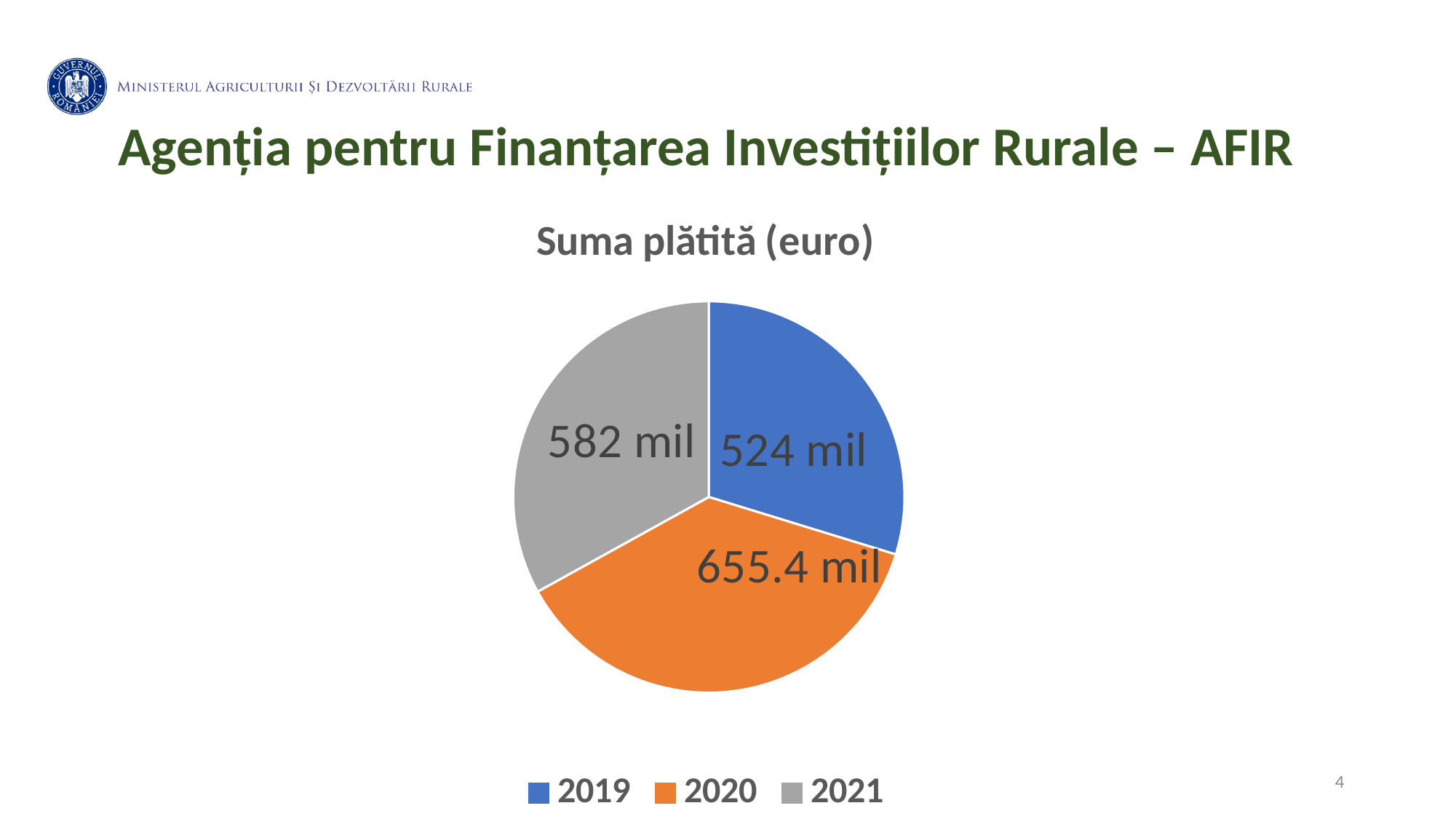
Which colour represents 2021 in the legend? Gray What is the value shown for 2021? 582 mil What is the value shown for 2019? 524 mil What is the difference between the values for 2020 and 2019? 131.4 mil What is the value shown for 2020? 655.4 mil What type of chart is shown on the slide? Pie chart Which year has the largest slice of the pie? 2020 What is the title of the chart? Suma plătită (euro) How many slices does the pie chart have? 3 What is the difference between the values for 2021 and 2019? 58 mil Which is larger, the value for 2021 or the value for 2019? 2021 Which year has the smallest slice of the pie? 2019